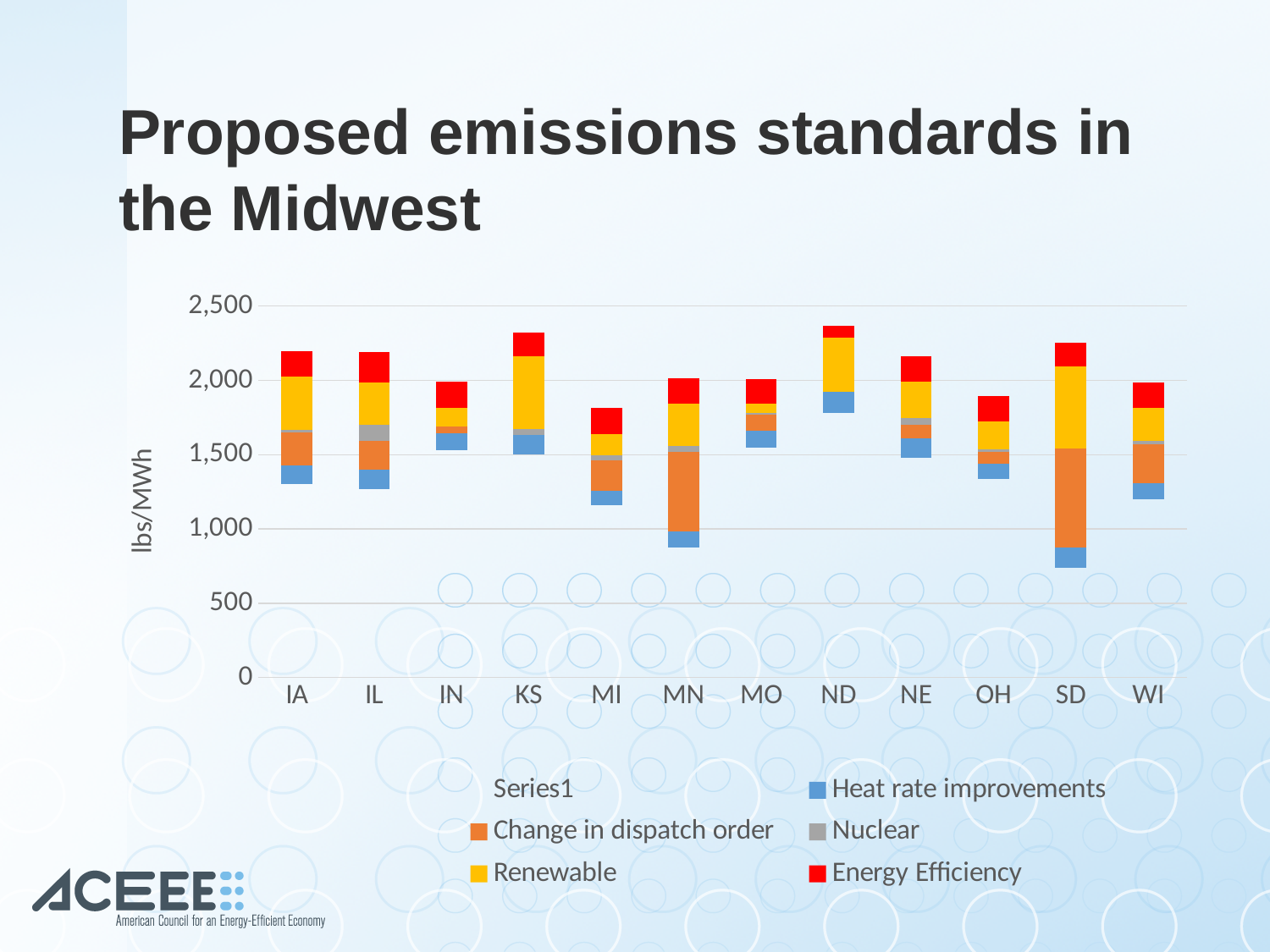
Is the bottom of the stacked bar for SD greater or less than 1,000 lbs/MWh? less Is the top of the stacked bar for KS greater or less than 2,000 lbs/MWh? greater Which stacked bar reaches higher on the vertical axis, ND or MI? ND Which state's stacked bar extends lowest on the vertical axis? SD How many states are shown on the x axis of the chart? 12 Is the top of the stacked bar for ND greater or less than 2,000 lbs/MWh? greater What kind of chart is shown on the slide? Stacked bar chart What is the label on the vertical axis of the chart? lbs/MWh Which state has the largest 'Change in dispatch order' segment? SD What is the title of the chart on the slide? Proposed emissions standards in the Midwest How many series does the chart's legend list? 6